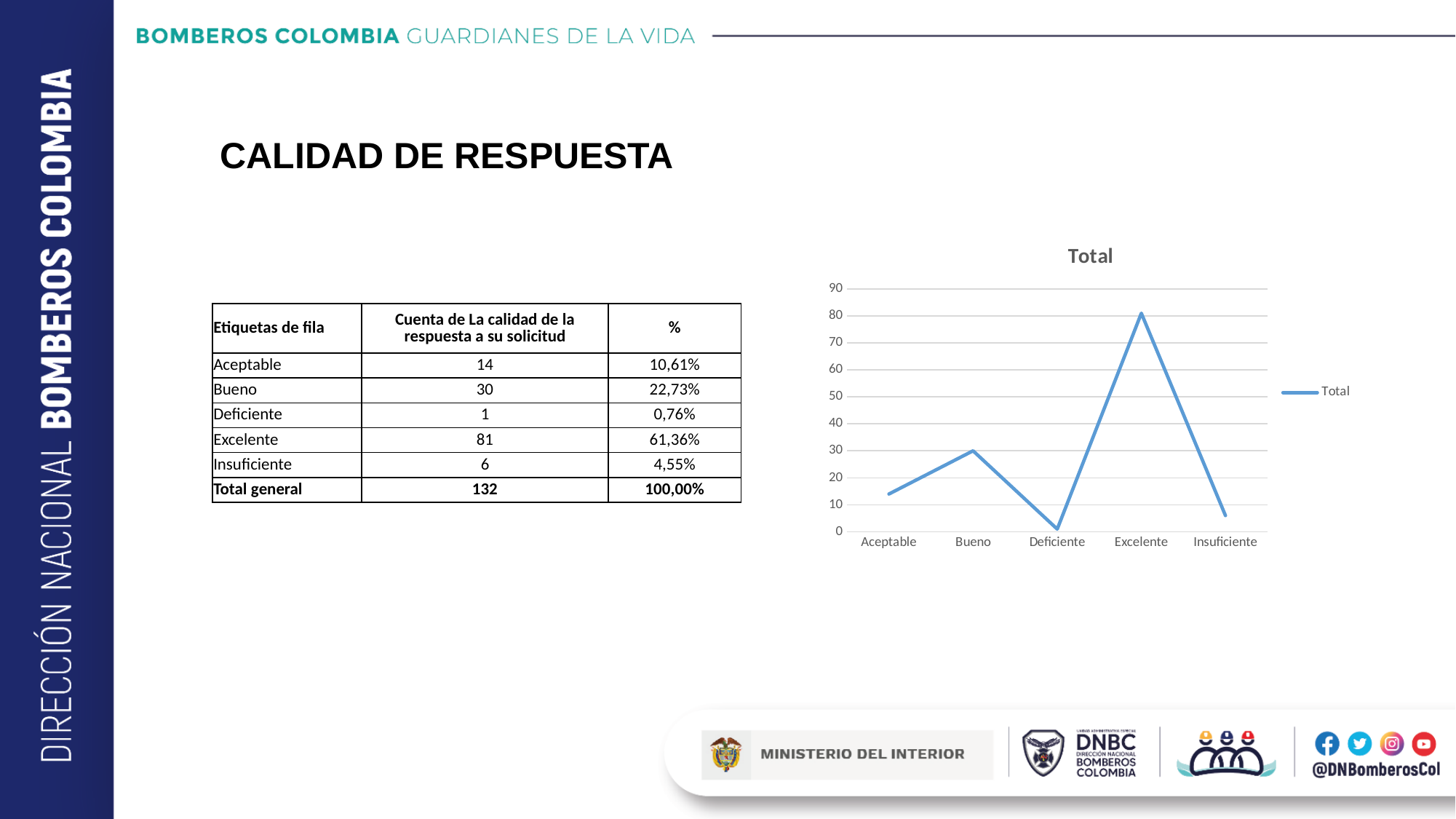
How many series does the chart legend list? 1 What is the value for Bueno in the chart? 30 What is the value for Excelente in the chart? 81 Which category has the lowest value in the chart? Deficiente What is the title of the chart? Total Which is larger in the chart, the value for Aceptable or the value for Bueno? Bueno Which category has the highest value in the chart? Excelente What kind of chart is shown on the slide? line chart Is the value for Insuficiente greater or less than 10? less What is the difference between the values for Excelente and Bueno? 51 Is the value for Excelente greater or less than 70? greater How many categories are plotted along the x axis of the chart? 5